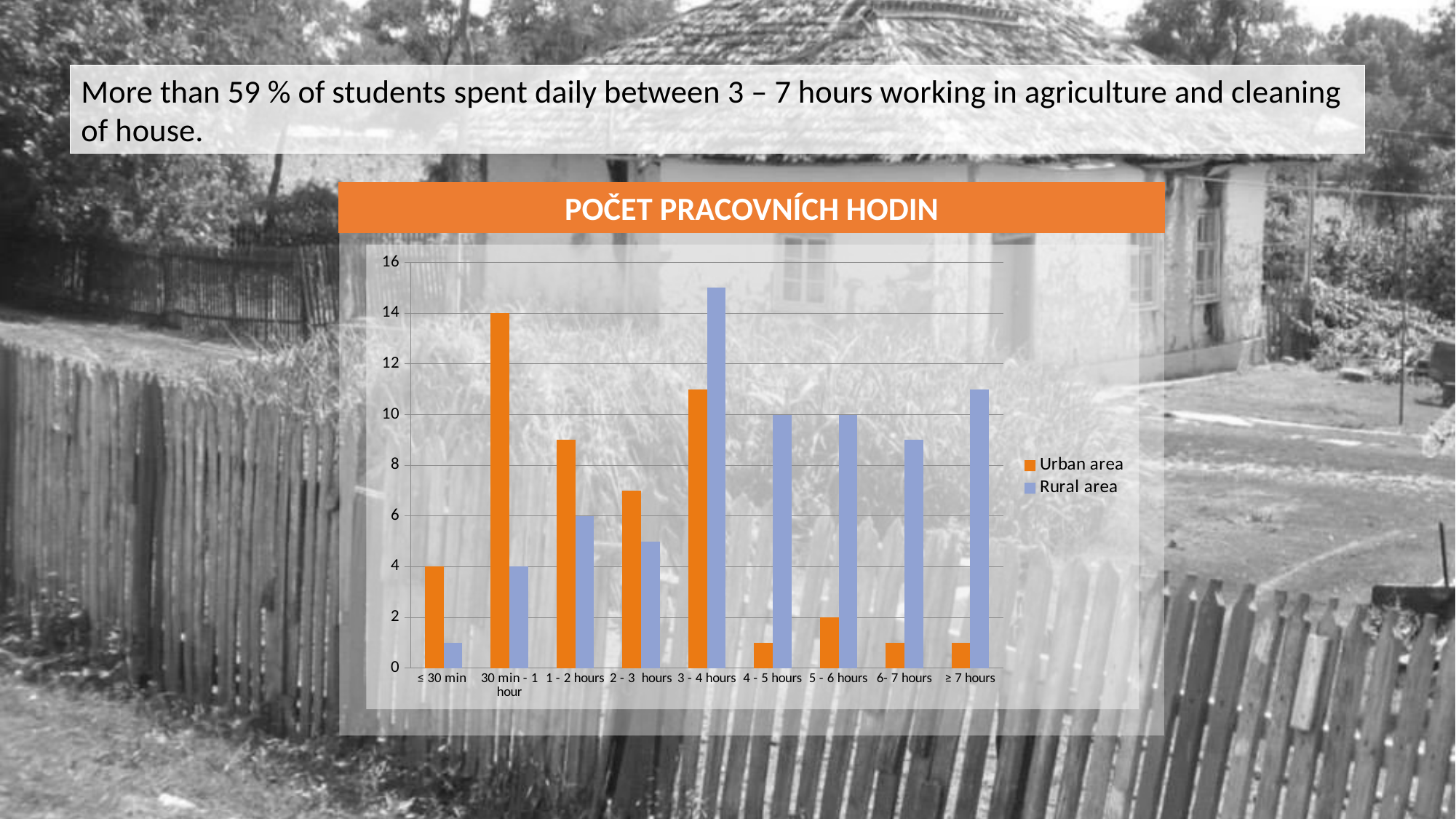
What is the difference between Urban area and Rural area in the '30 min - 1 hour' category? 10 Is the value for Rural area in the '6- 7 hours' category greater or less than 8? greater What is the title of the chart? POČET PRACOVNÍCH HODIN Which category has the lowest Rural area value? ≤ 30 min What is the value for Urban area in the '≤ 30 min' category? 4 What is the value for Rural area in the '4 - 5 hours' category? 10 How many categories are shown on the x axis? 9 Which category has the highest Rural area value? 3 - 4 hours How many series does the legend list? 2 What is the value for Urban area in the '30 min - 1 hour' category? 14 What type of chart is shown on the slide? Bar chart In the '3 - 4 hours' category, which is larger: Urban area or Rural area? Rural area